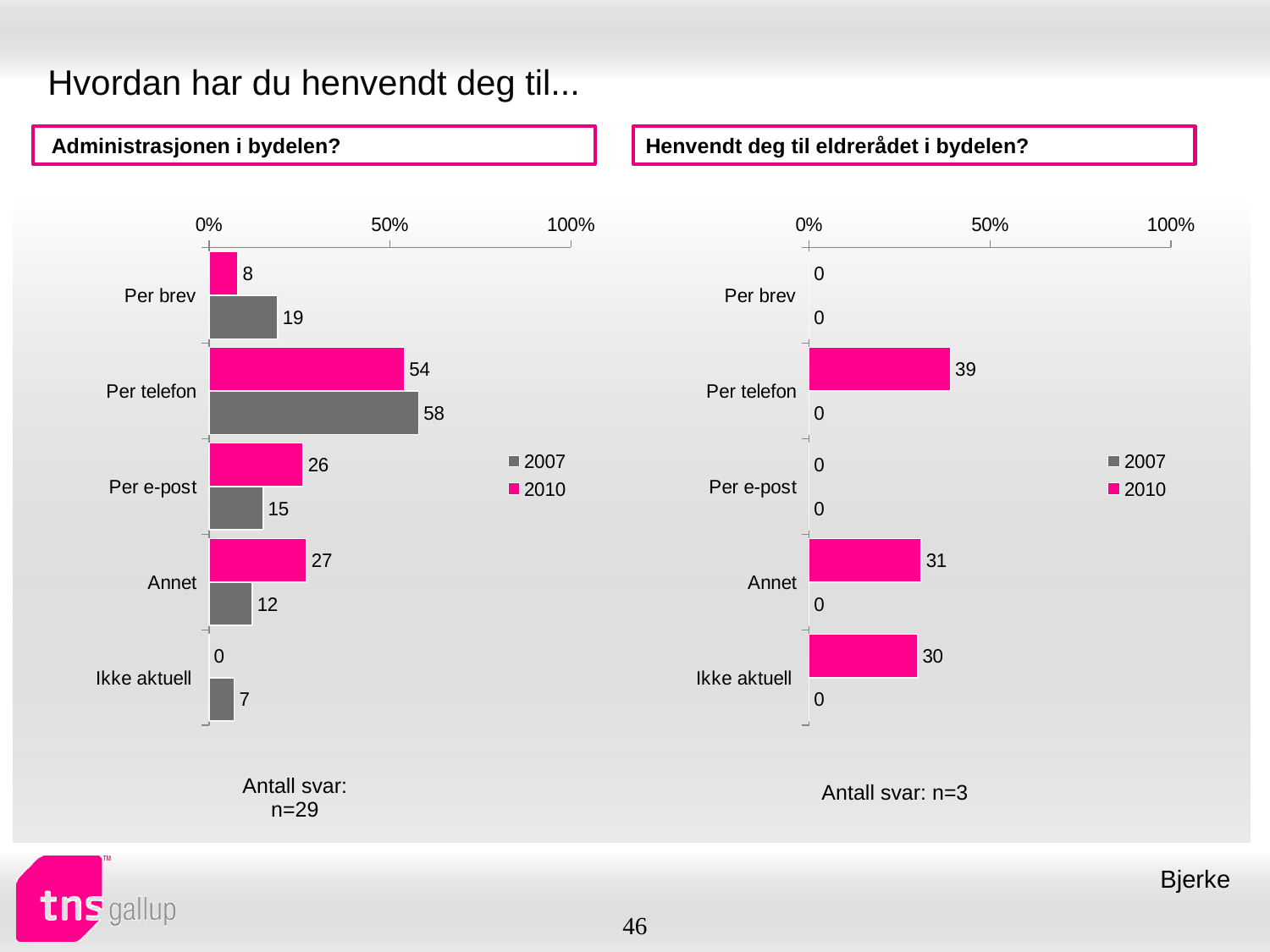
In the chart 'Henvendt deg til eldrerådet i bydelen?', what is the value for Per telefon in 2010? 39 How many series does the legend list in the chart 'Henvendt deg til eldrerådet i bydelen?'? 2 In the chart 'Administrasjonen i bydelen?', which category has the highest value for 2010? Per telefon In the chart 'Henvendt deg til eldrerådet i bydelen?', what is the value for Annet in 2007? 0 In the chart 'Henvendt deg til eldrerådet i bydelen?', which category has the highest value for 2010? Per telefon In the chart 'Henvendt deg til eldrerådet i bydelen?', what is the difference between the 2010 values for Annet and Ikke aktuell? 1 In the chart 'Administrasjonen i bydelen?', what is the value for Per brev in 2010? 8 In the chart 'Administrasjonen i bydelen?', which category has the lowest value for 2007? Ikke aktuell In the chart 'Administrasjonen i bydelen?', which is larger for Annet: the 2007 value or the 2010 value? 2010 How many categories are shown in the chart 'Administrasjonen i bydelen?'? 5 In the chart 'Administrasjonen i bydelen?', what is the value for Per telefon in 2007? 58 In the chart 'Administrasjonen i bydelen?', what is the difference between the 2007 and 2010 values for Per e-post? 11